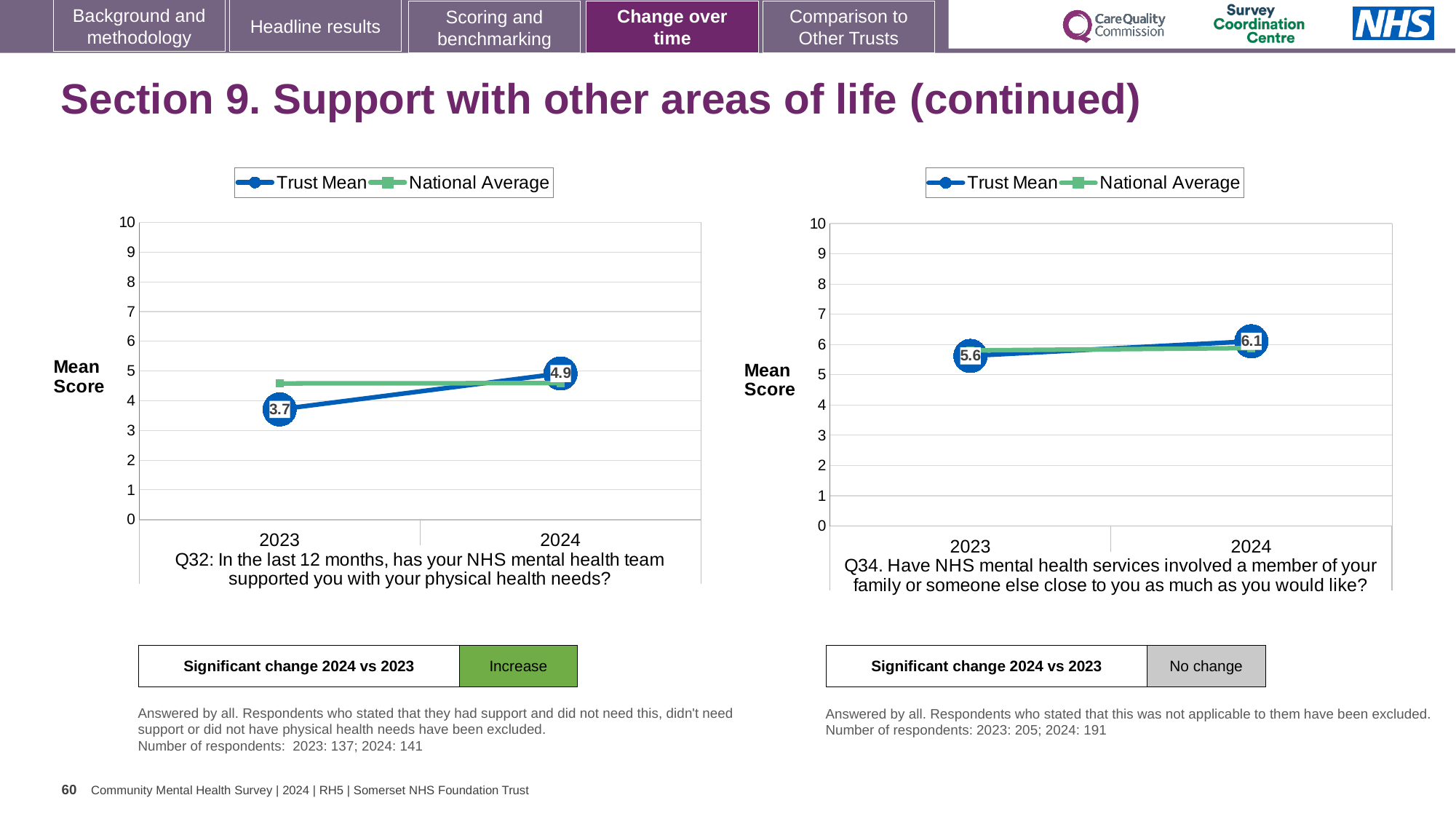
In the Q34 chart on the right, what is the difference between the Trust Mean for 2024 and 2023? 0.5 How many series does the legend of the Q32 chart on the left list? 2 In the Q32 chart on the left, does the Trust Mean rise or fall from 2023 to 2024? rise In the Q32 chart on the left, what is the Trust Mean score for 2024? 4.9 How many years are shown on the x axis of the Q34 chart on the right? 2 In the Q32 chart on the left, is the National Average for 2023 greater or less than 4? greater What type of chart is the Q34 chart on the right? line chart In the Q34 chart on the right, what is the Trust Mean score for 2024? 6.1 In the Q32 chart on the left, by how much did the Trust Mean change from 2023 to 2024? 1.2 In the Q32 chart on the left, which is larger for 2023: the Trust Mean or the National Average? National Average In the Q32 chart on the left, what is the Trust Mean score for 2023? 3.7 In the Q34 chart on the right, what is the Trust Mean score for 2023? 5.6